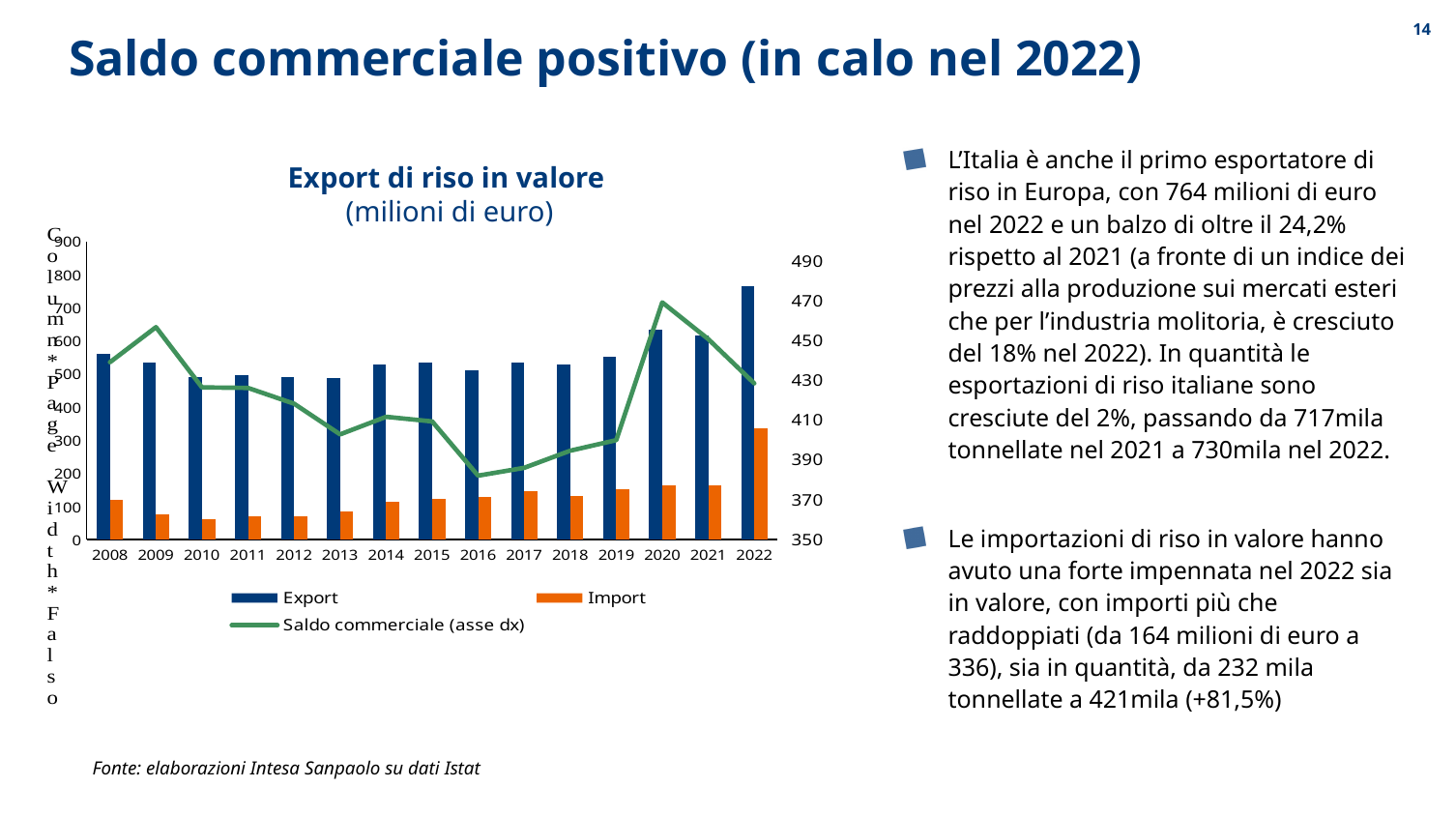
How many series does the legend list? 3 Which series is plotted on the right-hand axis? Saldo commerciale (asse dx) In which year is the Import bar highest? 2022 In which year does the Saldo commerciale line reach its highest point? 2020 What kind of chart is shown on the slide? Combined bar and line chart What is the title of the chart? Export di riso in valore (milioni di euro) Is the Saldo commerciale value for 2022 greater or less than 450? less In which year does the Saldo commerciale line reach its lowest point? 2016 In which year is the Export bar highest? 2022 How many years are shown on the x axis? 15 Is the Import value for 2022 greater or less than 300? greater Is the Export value for 2022 greater or less than 700? greater